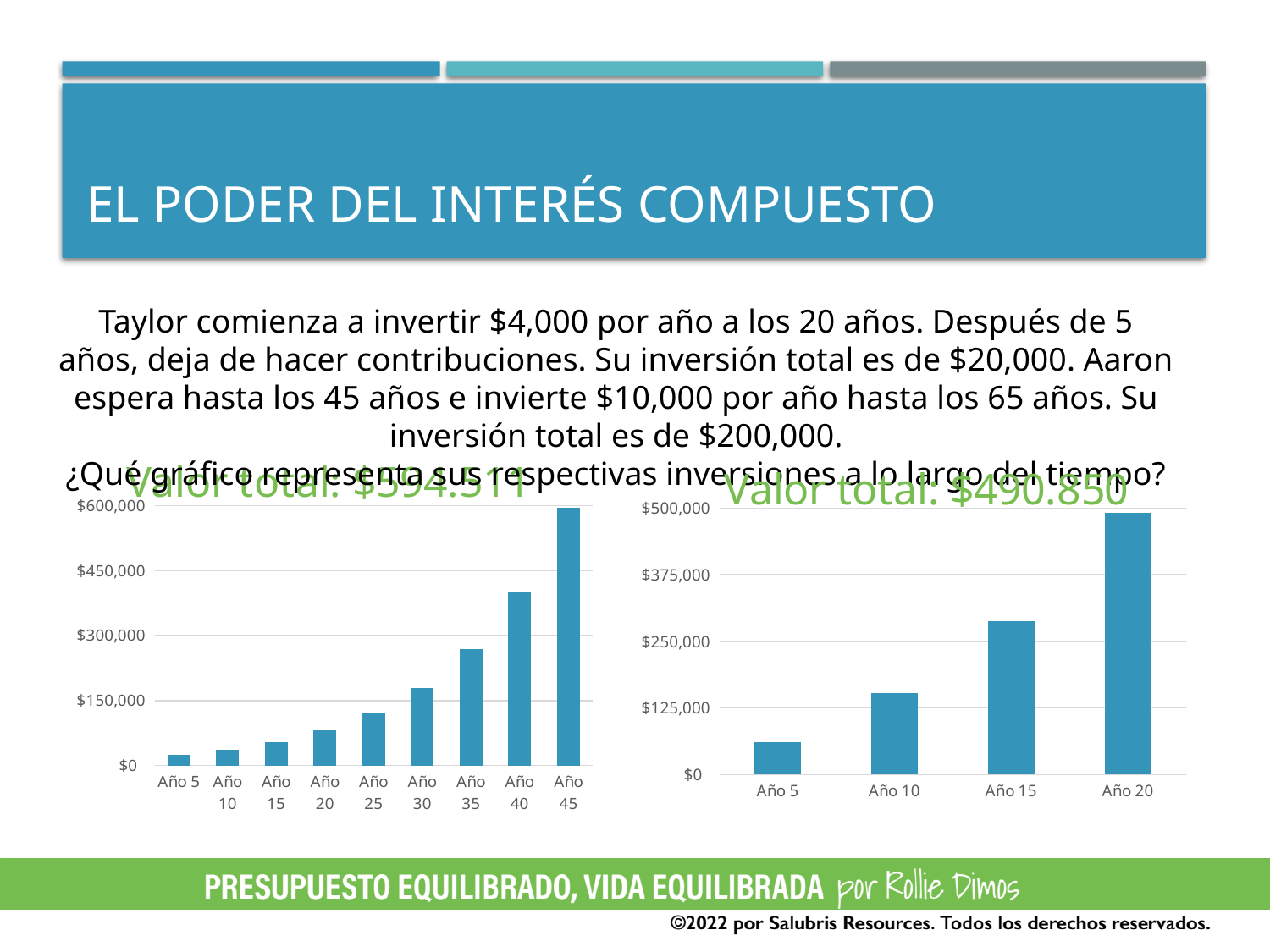
In the right chart, which category has the lowest value? Año 5 In the right chart, which category has the highest value? Año 20 In the left chart, which category has the highest value? Año 45 In the left chart, which category has the lowest value? Año 5 In the left chart, is the value for Año 30 greater or less than $150,000? greater What kind of chart is the left chart on the slide? bar chart How many categories are shown on the x axis of the left chart? 9 In the left chart, which is larger, the value for Año 35 or the value for Año 25? Año 35 In the right chart, is the value for Año 15 greater or less than $250,000? greater How many categories are shown on the x axis of the right chart? 4 In the right chart, do the values rise or fall from Año 5 to Año 20? rise In the left chart, is the value for Año 40 greater or less than $450,000? less